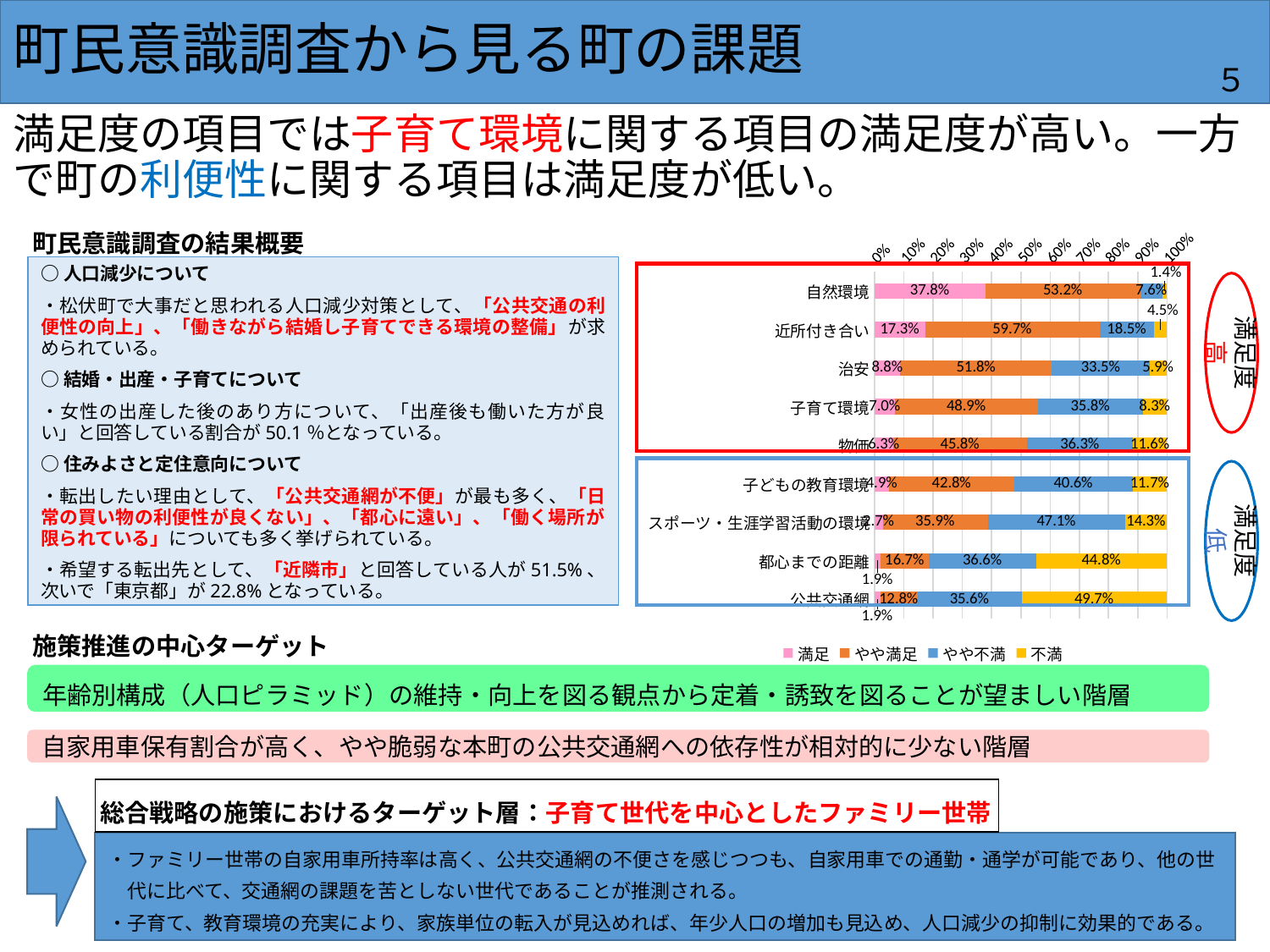
What is the 満足 value for 近所付き合い? 17.3% What is the やや満足 value for 自然環境? 53.2% Which is larger, the やや満足 value for 治安 or for 子育て環境? 治安 How many series does the chart legend list? 4 Which category has the highest 満足 value? 自然環境 What kind of chart is shown on the slide? Stacked bar chart What is the 不満 value for 公共交通網? 49.7% What is the やや不満 value for スポーツ・生涯学習活動の環境? 47.1% Which category has the highest 不満 value? 公共交通網 What is the difference between the 不満 values for 都心までの距離 and 公共交通網? 4.9% How many categories are plotted in the chart? 9 What are the four legend entries of the chart? 満足, やや満足, やや不満, 不満